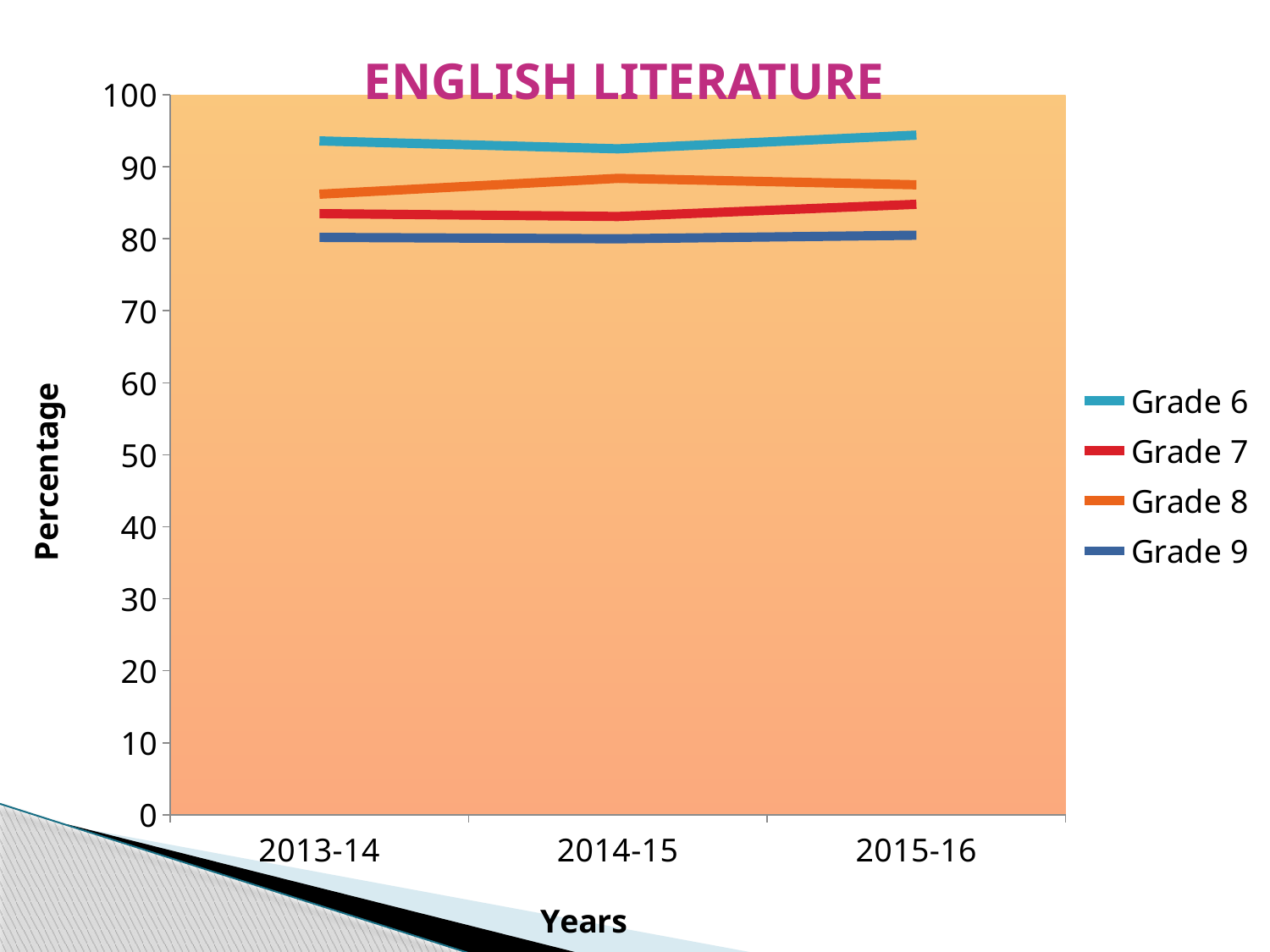
In 2014-15, which is larger: the value for Grade 8 or the value for Grade 7? Grade 8 How many years are shown on the x axis? 3 What is the title of the chart? ENGLISH LITERATURE Is the value for Grade 6 in 2014-15 greater or less than 90? greater In 2015-16, which is larger: the value for Grade 6 or the value for Grade 9? Grade 6 Is the value for Grade 9 in 2013-14 greater or less than 90? less Is the value for Grade 8 in 2015-16 greater or less than 80? greater What kind of chart is shown on the slide? Line chart Which grade has the highest percentage across all years? Grade 6 What is the label of the y axis? Percentage Which grade has the lowest percentage across all years? Grade 9 How many series does the legend list? 4